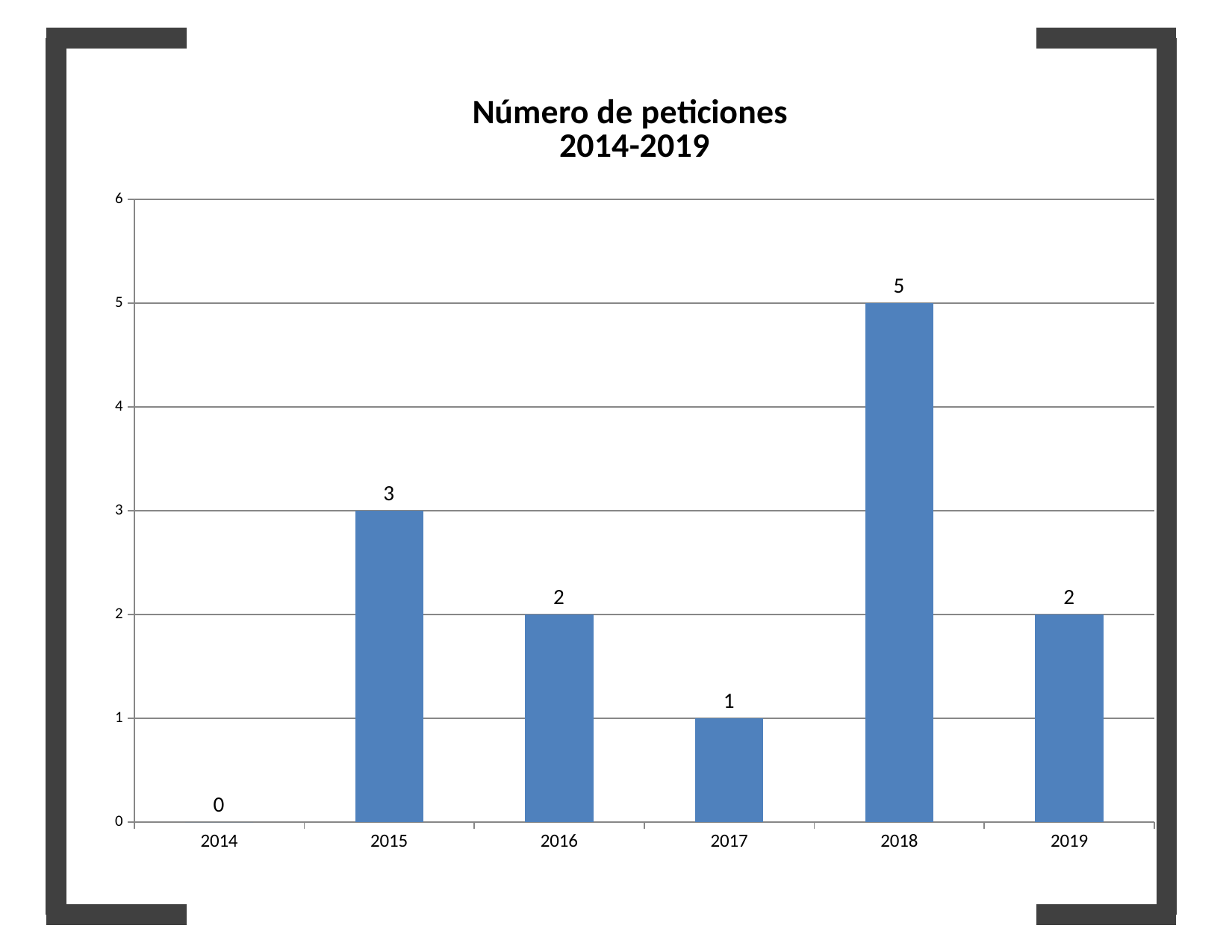
Is the value for 2018 greater or less than 4? greater Which year has the lowest value? 2014 What is the value for 2014? 0 How many years are shown on the x axis? 6 What is the difference between the values for 2018 and 2017? 4 What is the value for 2015? 3 Which is larger, the value for 2015 or the value for 2019? 2015 Which year has the highest value? 2018 What is the value for 2018? 5 Do the values rise or fall from 2016 to 2017? fall What kind of chart is this? bar chart What is the title of the chart? Número de peticiones 2014-2019